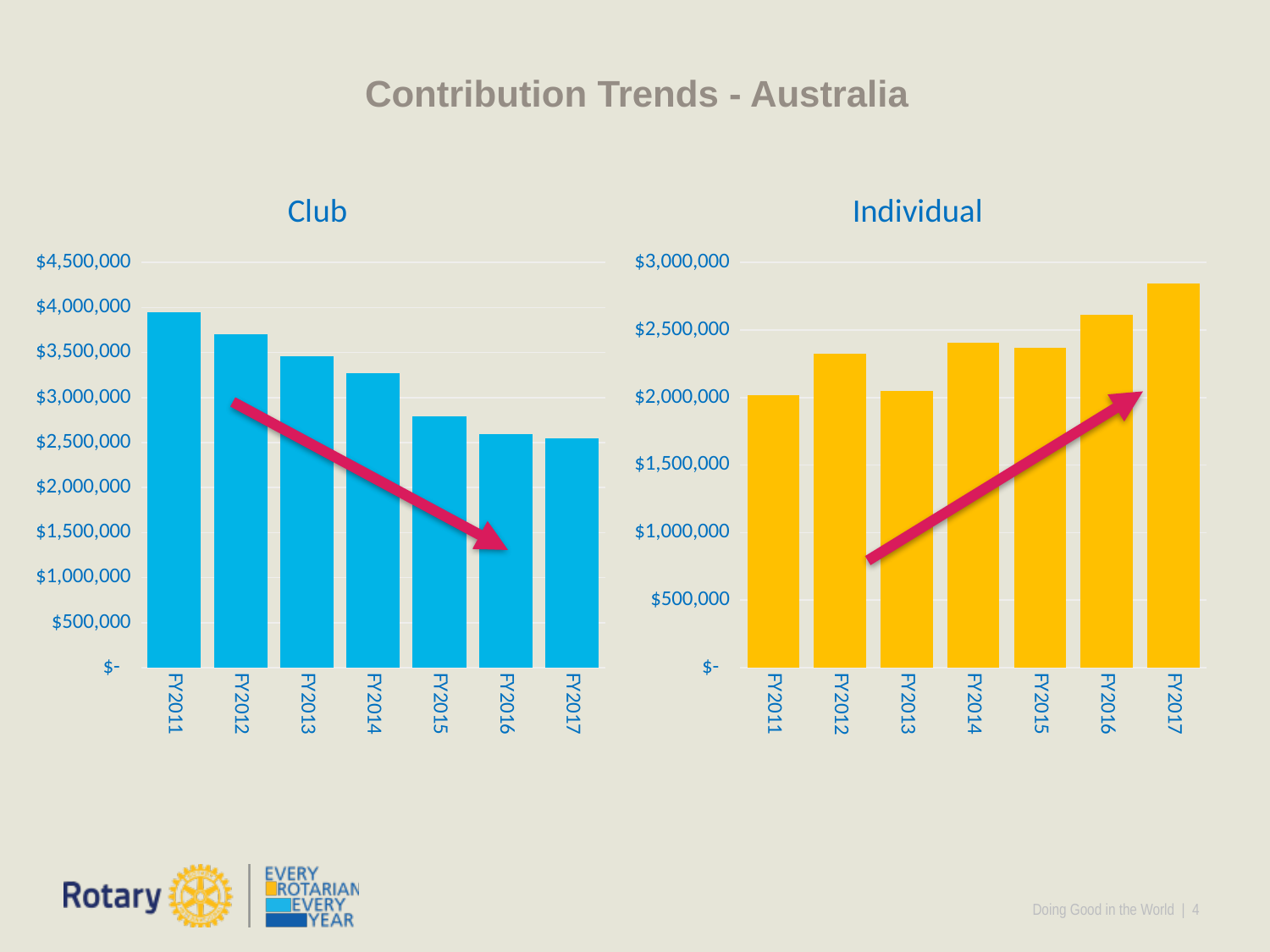
What kind of chart is the Club chart? bar chart On the Individual chart, do contributions generally rise or fall from FY2011 to FY2017? rise On the Individual chart, is the value for FY2017 greater or less than $2,500,000? greater On the Club chart, is the value for FY2011 greater or less than $3,500,000? greater How many fiscal years are shown on the Individual chart? 7 On the Club chart, do contributions rise or fall from FY2011 to FY2017? fall What colour are the bars on the Individual chart? yellow On the Individual chart, which fiscal year has the highest contribution? FY2017 On the Club chart, is the value for FY2015 greater or less than $3,000,000? less On the Club chart, which fiscal year has the highest contribution? FY2011 On the Individual chart, which is larger, the value for FY2016 or the value for FY2013? FY2016 On the Club chart, which is larger, the value for FY2012 or the value for FY2015? FY2012